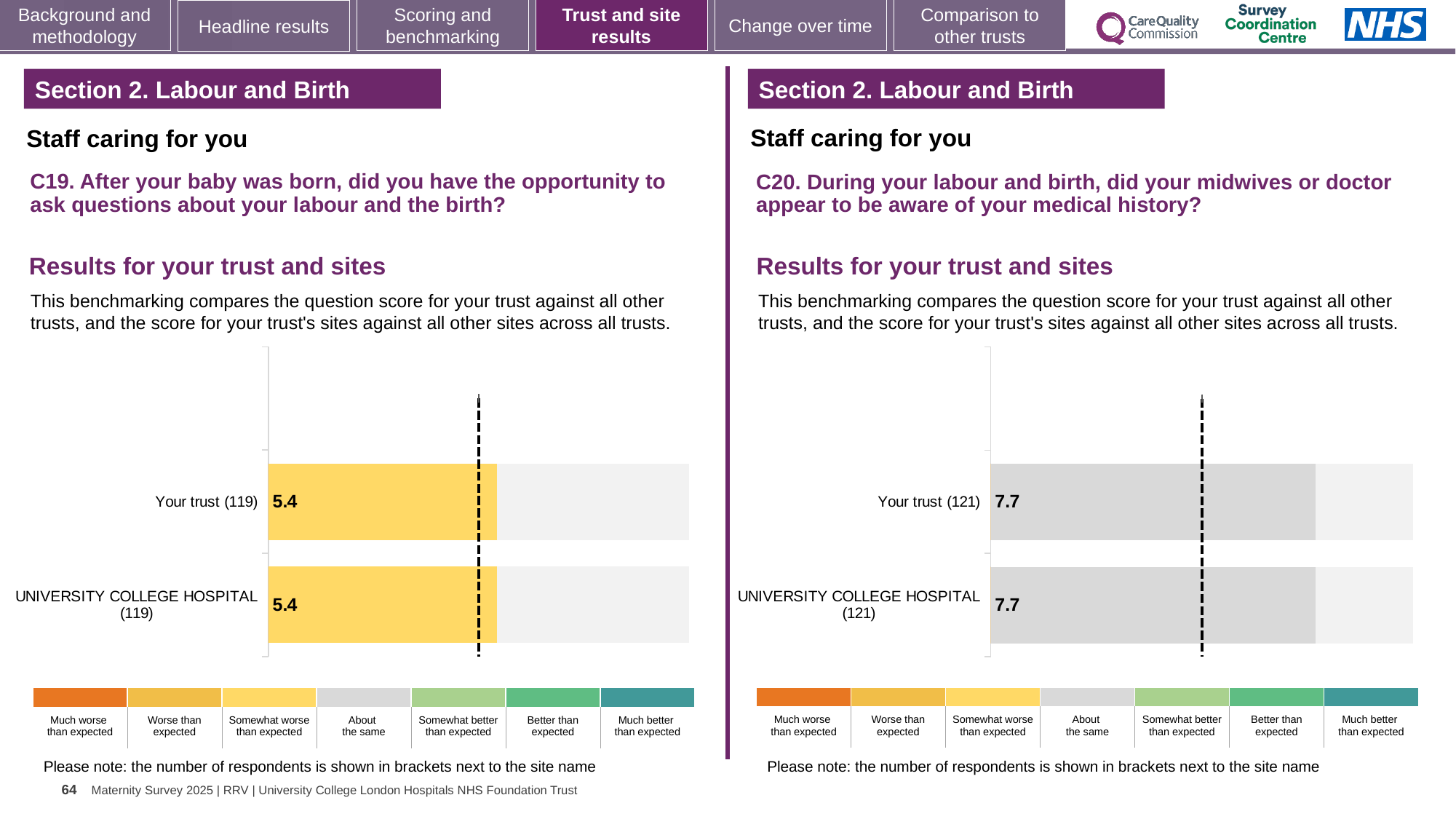
On the left chart (C19), what is the score for UNIVERSITY COLLEGE HOSPITAL? 5.4 According to the legend, which benchmarking category does the bar colour on the right chart (C20) represent? About the same On the right chart (C20), what is the score for Your trust? 7.7 On the left chart (C19), what is the score for Your trust? 5.4 On the left chart (C19), what is the difference between the score for Your trust and the score for UNIVERSITY COLLEGE HOSPITAL? 0 On the right chart (C20), what is the score for UNIVERSITY COLLEGE HOSPITAL? 7.7 How many categories does the colour legend below the left chart (C19) list? 7 How many bars are plotted on the right chart (C20)? 2 On the right chart (C20), what is the difference between the score for Your trust and the score for UNIVERSITY COLLEGE HOSPITAL? 0 How many bars are plotted on the left chart (C19)? 2 How many respondents are shown in brackets for Your trust on the right chart (C20)? 121 What type of chart is used on the left (C19)? Bar chart